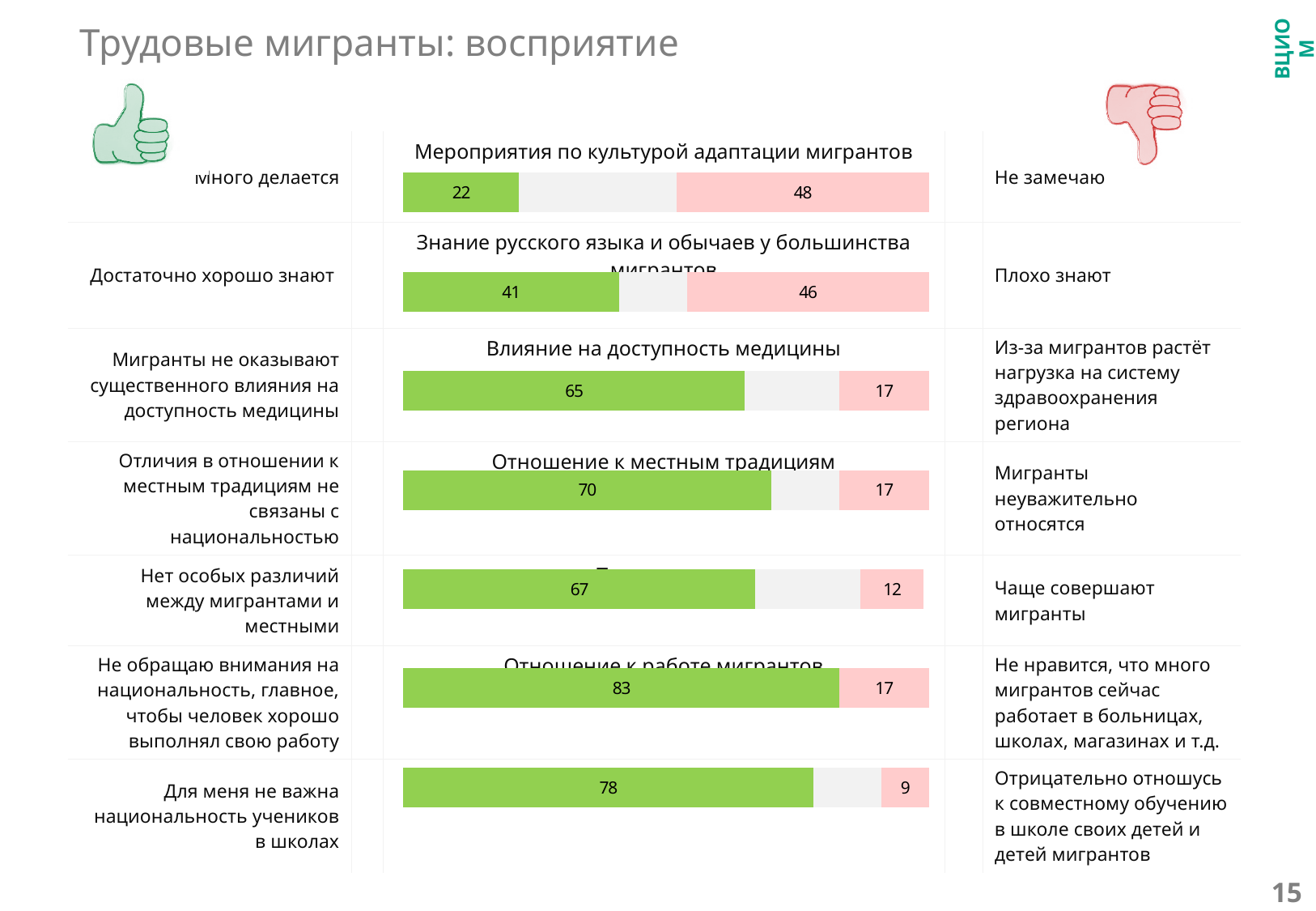
In the bar titled "Отношение к местным традициям", what is the difference between the green and pink values? 53 What kind of chart is used on the slide? bar chart In the bottom bar ("Для меня не важна национальность учеников в школах"), what is the pink value? 9 How many stacked bars are shown on the slide? 7 In the bar titled "Знание русского языка и обычаев у большинства мигрантов", what is the pink value? 46 In the bar titled "Отношение к работе мигрантов", what is the green value? 83 What is the title of the slide? Трудовые мигранты: восприятие In the bar titled "Мероприятия по культурой адаптации мигрантов", what is the pink (negative) value? 48 Across all the bars on the slide, which bar has the lowest green value? Мероприятия по культурой адаптации мигрантов Across all the bars on the slide, which bar has the highest green value? Отношение к работе мигрантов In the bar titled "Мероприятия по культурой адаптации мигрантов", which is larger, the green value or the pink value? the pink value In the bar titled "Влияние на доступность медицины", what is the green (positive) value? 65